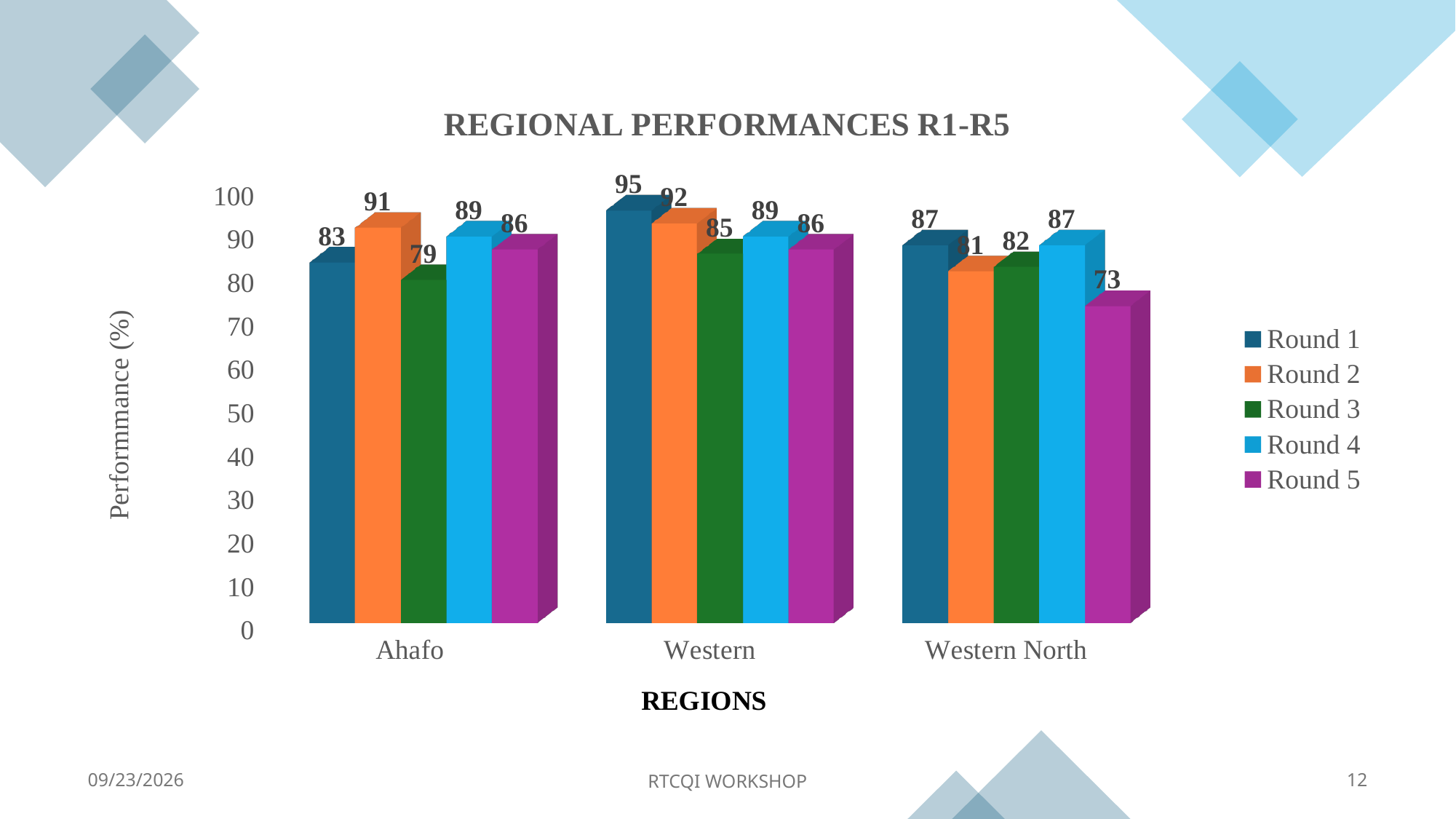
What is the title of the chart? REGIONAL PERFORMANCES R1-R5 What is the Round 3 value for Ahafo? 79 What is the Round 1 value for Western? 95 How many regions are shown on the x axis? 3 Which is larger, the Round 4 value for Ahafo or the Round 4 value for Western North? Ahafo Is the Round 5 value for Western North greater or less than 80? less Which region has the lowest Round 5 value? Western North What kind of chart is shown? bar chart What is the Round 5 value for Western North? 73 What is the difference between the Round 1 values for Western and Ahafo? 12 Which region has the highest Round 2 value? Western How many series does the legend list? 5